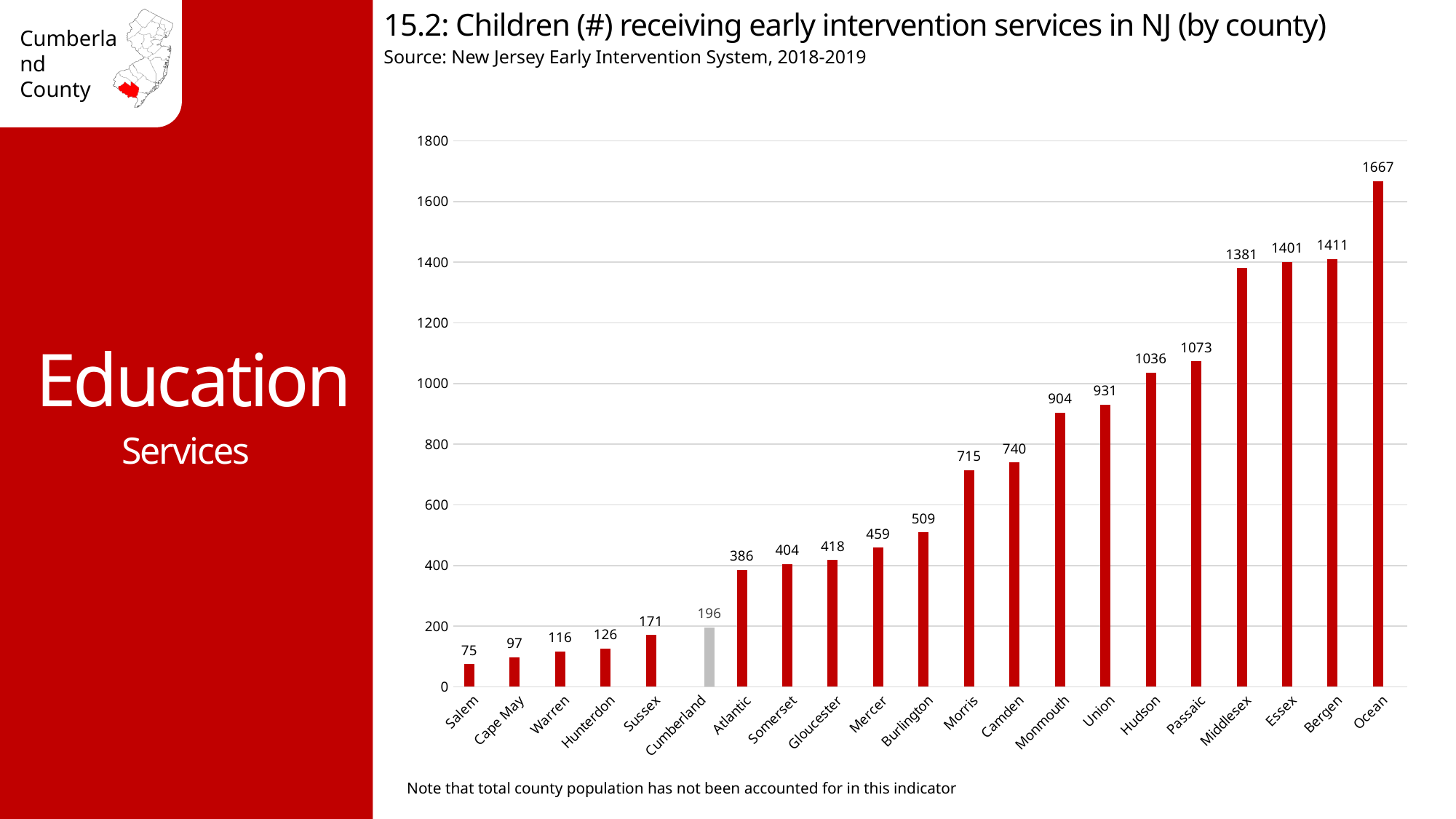
What is the difference between the values for Cumberland and Salem? 121 What is the difference between the values for Bergen and Essex? 10 Is the value for Passaic greater or less than 1000? greater Which county has the lowest number of children receiving early intervention services? Salem What kind of chart is shown on the slide? Bar chart What is the value shown for Ocean County? 1667 How many counties are shown on the x axis of the chart? 21 What is the value shown for Hudson County? 1036 Which county has the highest number of children receiving early intervention services? Ocean Which county has a larger value, Monmouth or Union? Union How many children received early intervention services in Cumberland County? 196 Do the values rise or fall moving from left to right along the x axis? Rise